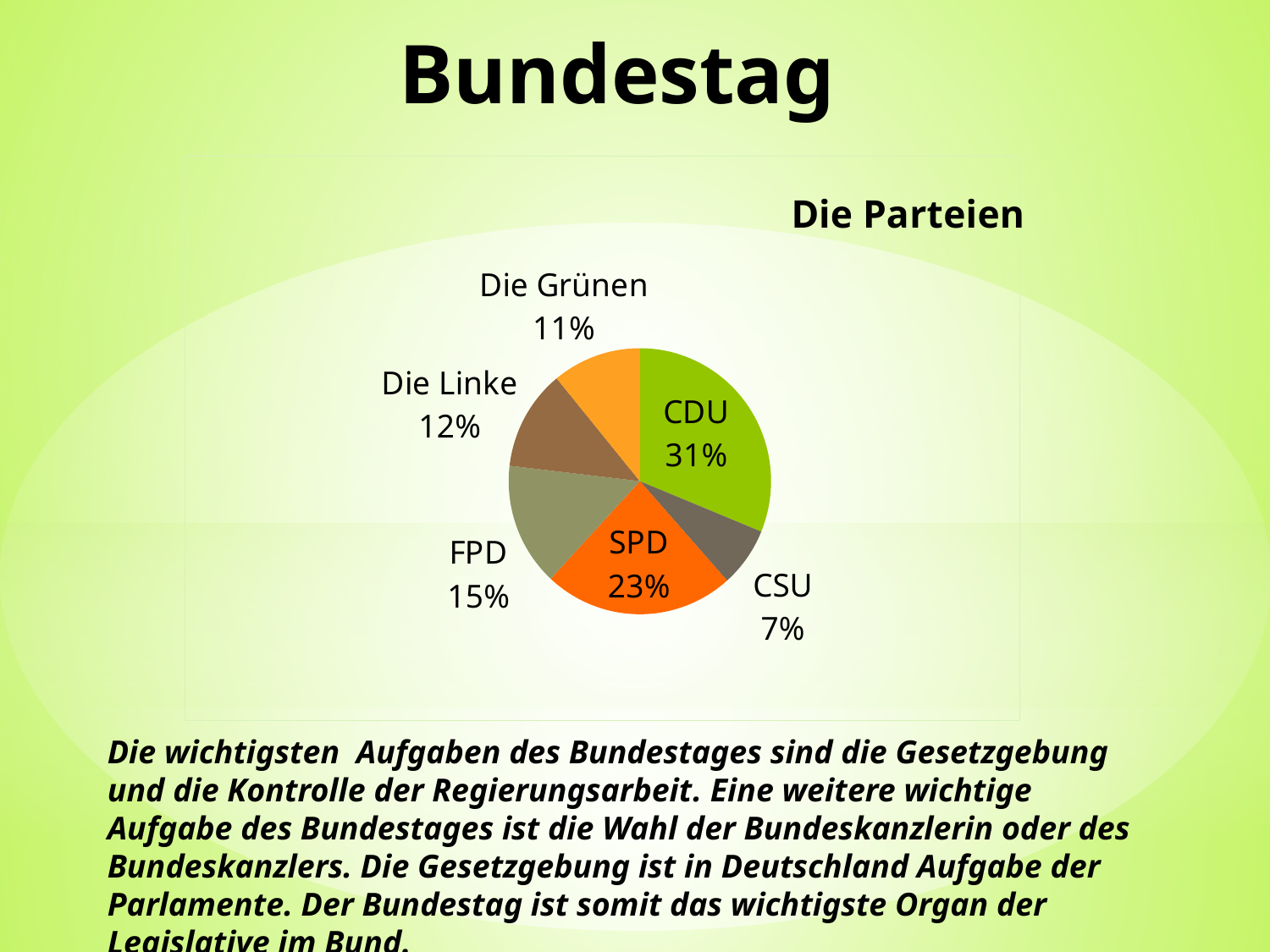
How many slices does the pie chart have? 6 Which party has the smallest slice of the pie? CSU What percentage does the CSU slice show? 7% What colour is the SPD slice? orange What kind of chart is shown on the slide? pie chart Which slice is larger, FPD or Die Grünen? FPD What percentage does the Die Linke slice show? 12% What is the difference in percentage points between the CDU and SPD slices? 8 What percentage does the CDU slice show? 31% What is the title of the chart? Die Parteien What percentage does the SPD slice show? 23% Which party has the largest slice of the pie? CDU